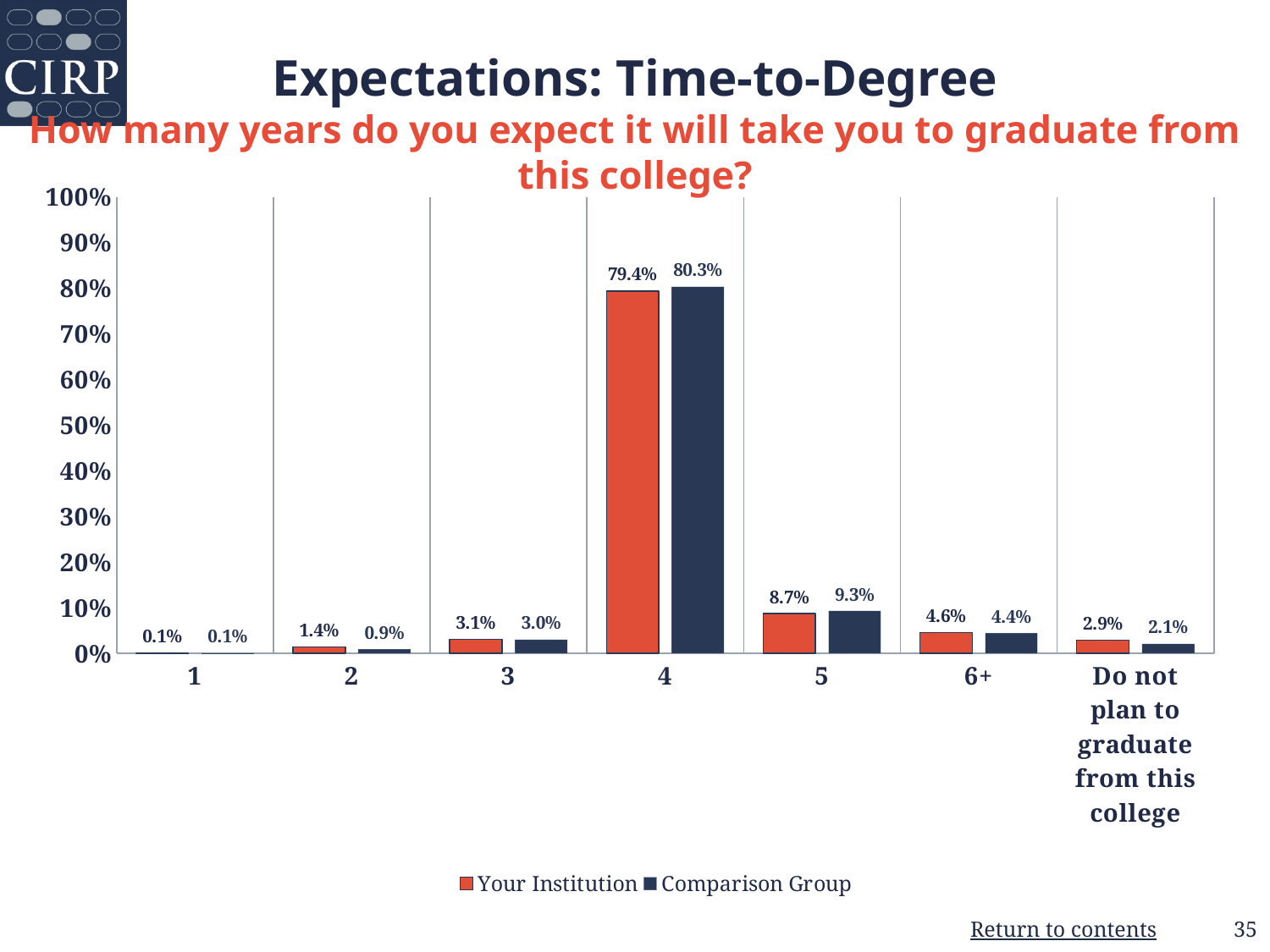
How many series does the legend list? 2 What is the value for Your Institution in the 'Do not plan to graduate from this college' category? 2.9% What is the difference between Comparison Group and Your Institution in category 4? 0.9% Which category has the lowest value for Your Institution? 1 Which category has the highest value for Comparison Group? 4 How many categories are shown on the x axis? 7 Which is larger in category 6+: Your Institution or Comparison Group? Your Institution Is the value for Your Institution in category 4 greater or less than 70%? greater Which series is shown in dark navy in the legend? Comparison Group What kind of chart is shown on the slide? bar chart What is the value for Your Institution in category 4? 79.4% What is the value for Comparison Group in category 5? 9.3%